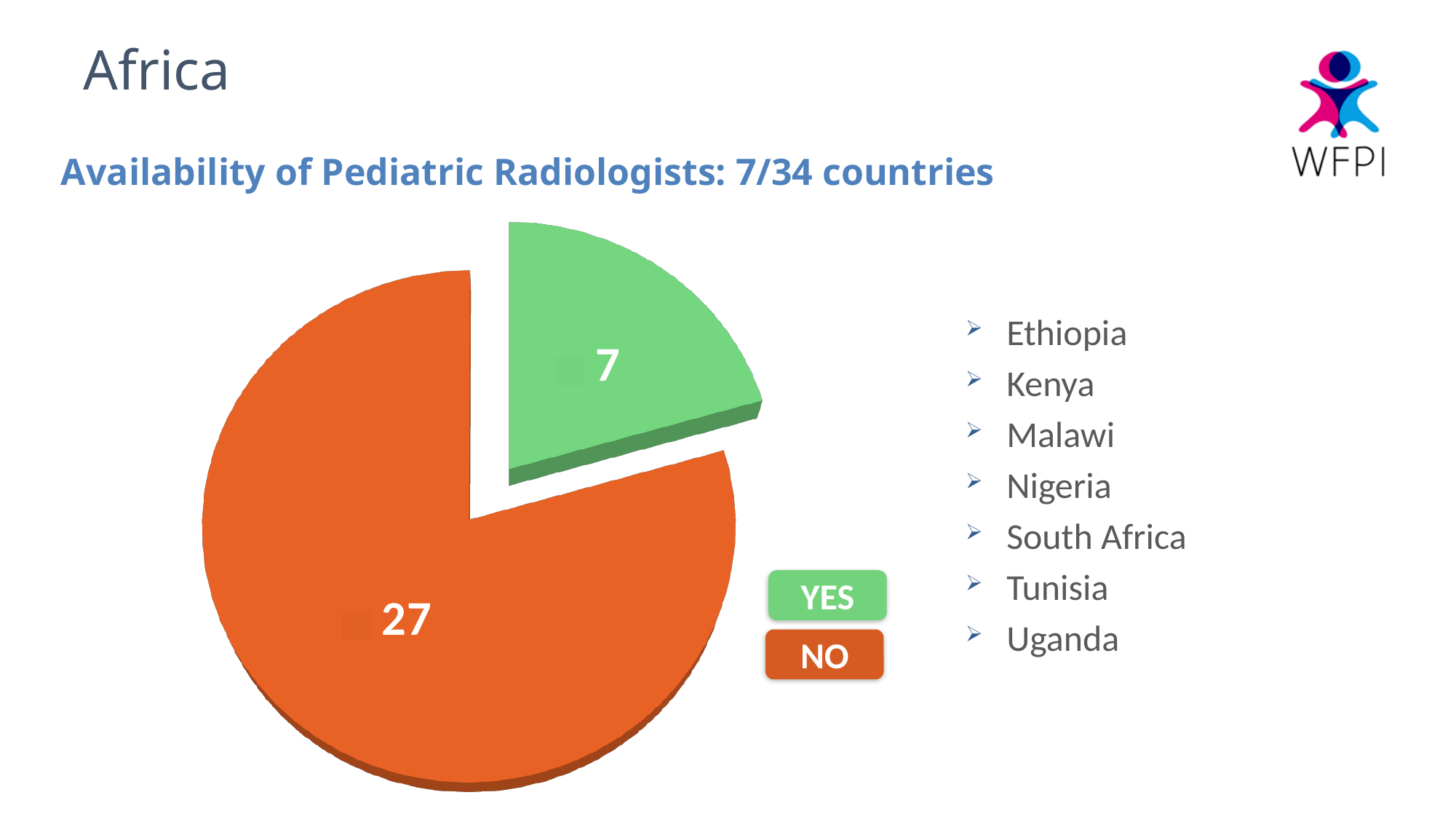
Which category has the smallest slice? YES What is the value of the YES slice? 7 What kind of chart is shown on the slide? pie chart Which slice is larger, YES or NO? NO What is the value of the NO slice? 27 What colour is the YES slice? green How many slices does the pie chart have? 2 How many entries does the legend list? 2 What is the difference between the NO and YES values? 20 What is the total of the two slices? 34 Which category has the largest slice? NO What colour is the NO slice? orange